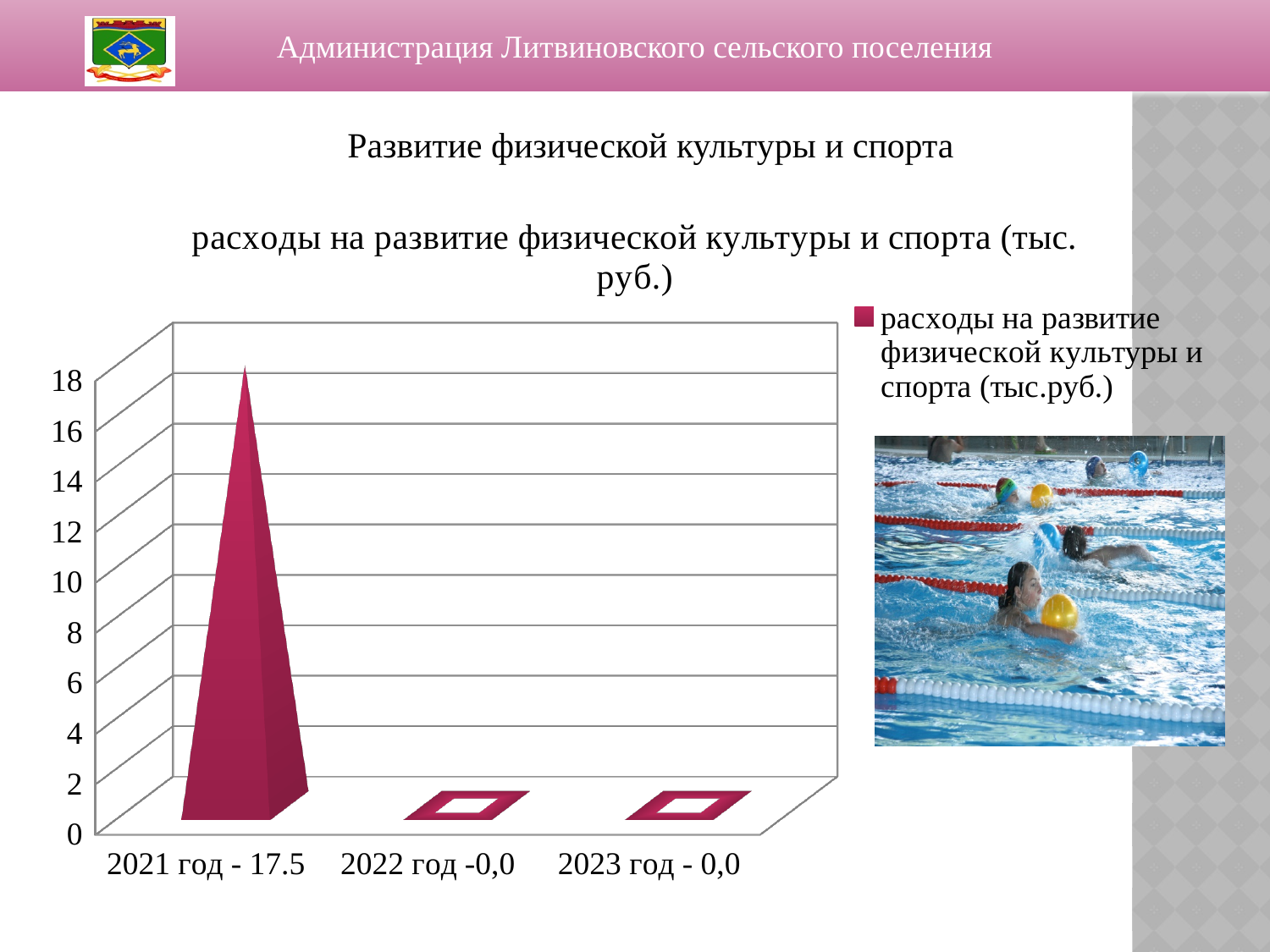
Which year has the highest value in the chart? 2021 год Is the value for 2021 год greater or less than 16? greater What is the title of the chart? расходы на развитие физической культуры и спорта (тыс. руб.) How many categories are shown on the x axis of the chart? 3 What is the difference between the value for 2021 год and the value for 2023 год? 17.5 What is the value for 2022 год according to the category label? 0,0 How many series does the chart legend list? 1 Which is larger, the value for 2021 год or the value for 2022 год? 2021 год What is the value for 2021 год according to the category label? 17.5 What type of chart is shown on the slide? bar chart Do the values rise or fall from 2021 год to 2023 год along the x axis? fall What is the value for 2023 год according to the category label? 0,0